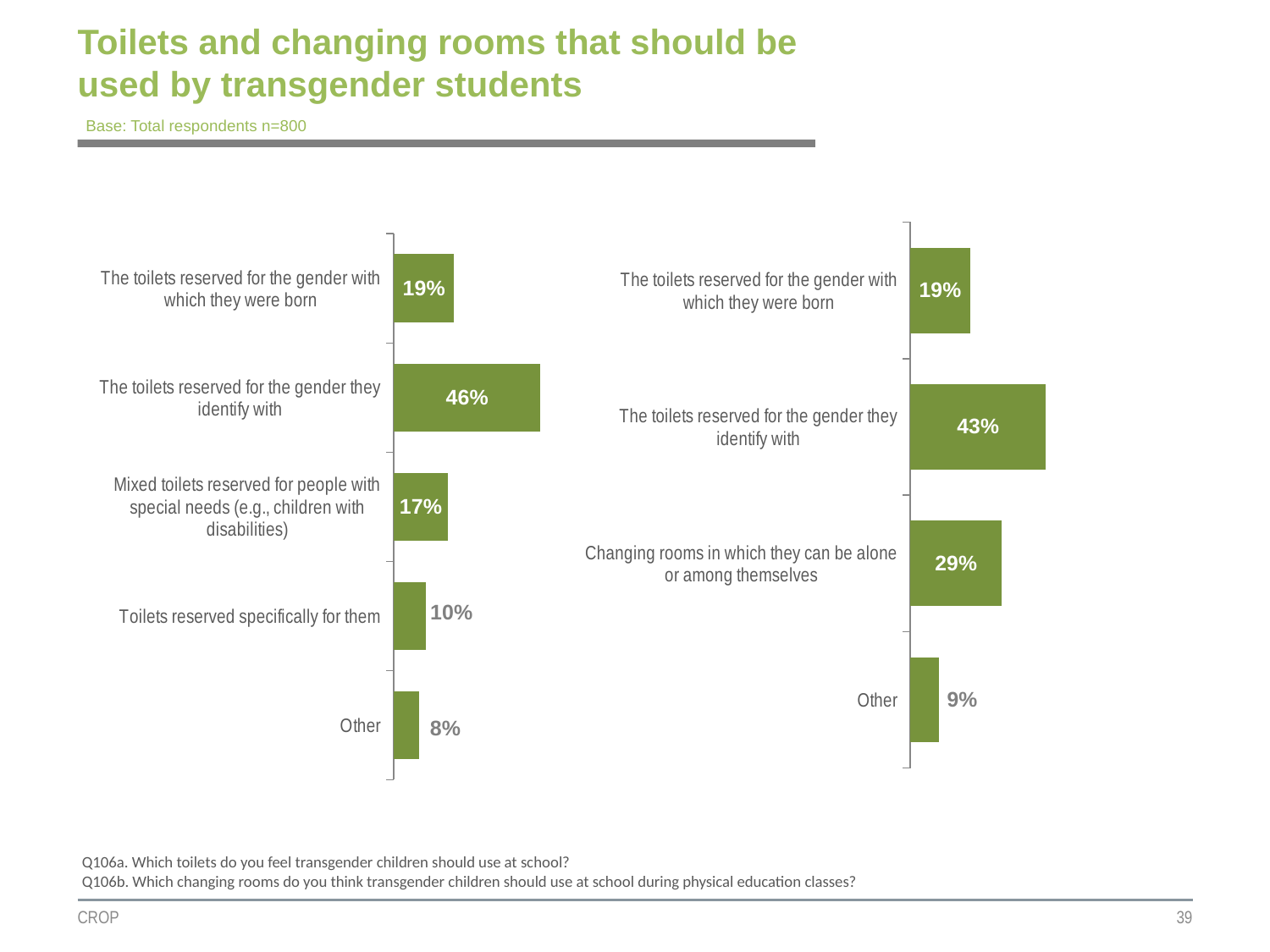
In the left chart, what percentage chose mixed toilets reserved for people with special needs? 17% In the left chart, what is the difference between the toilets reserved for the gender they identify with and the toilets reserved for the gender with which they were born? 27% In the right chart, what percentage chose 'Other'? 9% How many categories does the left chart show? 5 In the right chart, what is the difference between the toilets reserved for the gender they identify with and changing rooms in which they can be alone or among themselves? 14% What type of chart is the right chart? Bar chart In the left chart, which is larger: toilets reserved specifically for them or 'Other'? Toilets reserved specifically for them In the left chart, what percentage chose the toilets reserved for the gender they identify with? 46% In the left chart, which category has the highest value? The toilets reserved for the gender they identify with How many categories does the right chart show? 4 In the right chart, which category has the lowest value? Other In the right chart, what percentage chose changing rooms in which they can be alone or among themselves? 29%